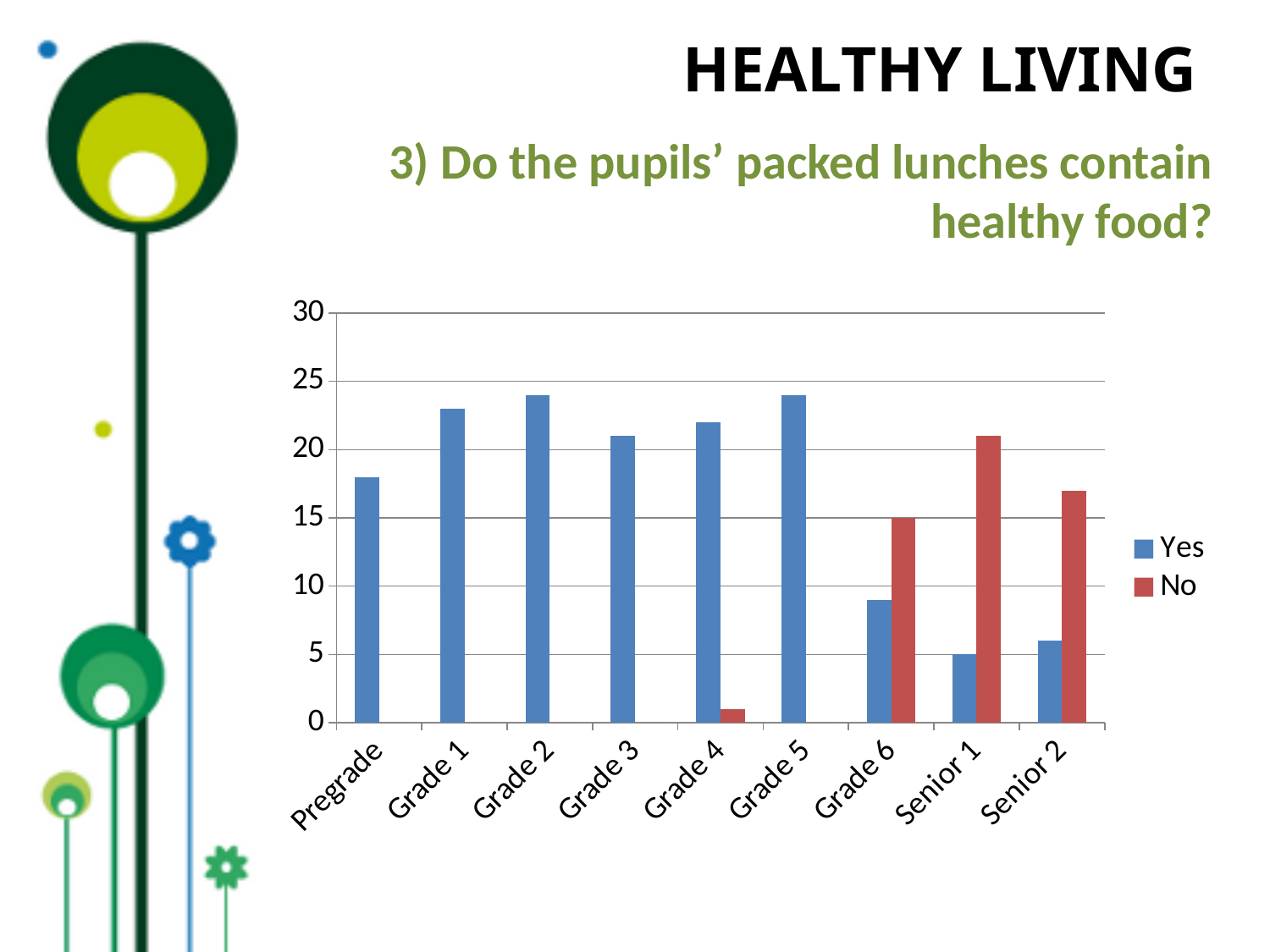
Which category has the highest 'No' value? Senior 1 Is the 'No' value for Senior 2 greater or less than 15? greater Is the 'Yes' value for Pregrade greater or less than 15? greater How many categories are shown on the x axis? 9 What kind of chart is shown on the slide? bar chart Which is larger, the 'Yes' value for Pregrade or the 'Yes' value for Grade 1? Grade 1 Which is larger for Senior 1, the 'Yes' value or the 'No' value? No Which is larger for Grade 6, the 'Yes' value or the 'No' value? No Is the 'Yes' value for Grade 2 greater or less than 25? less What are the two series named in the legend? Yes and No How many series does the legend list? 2